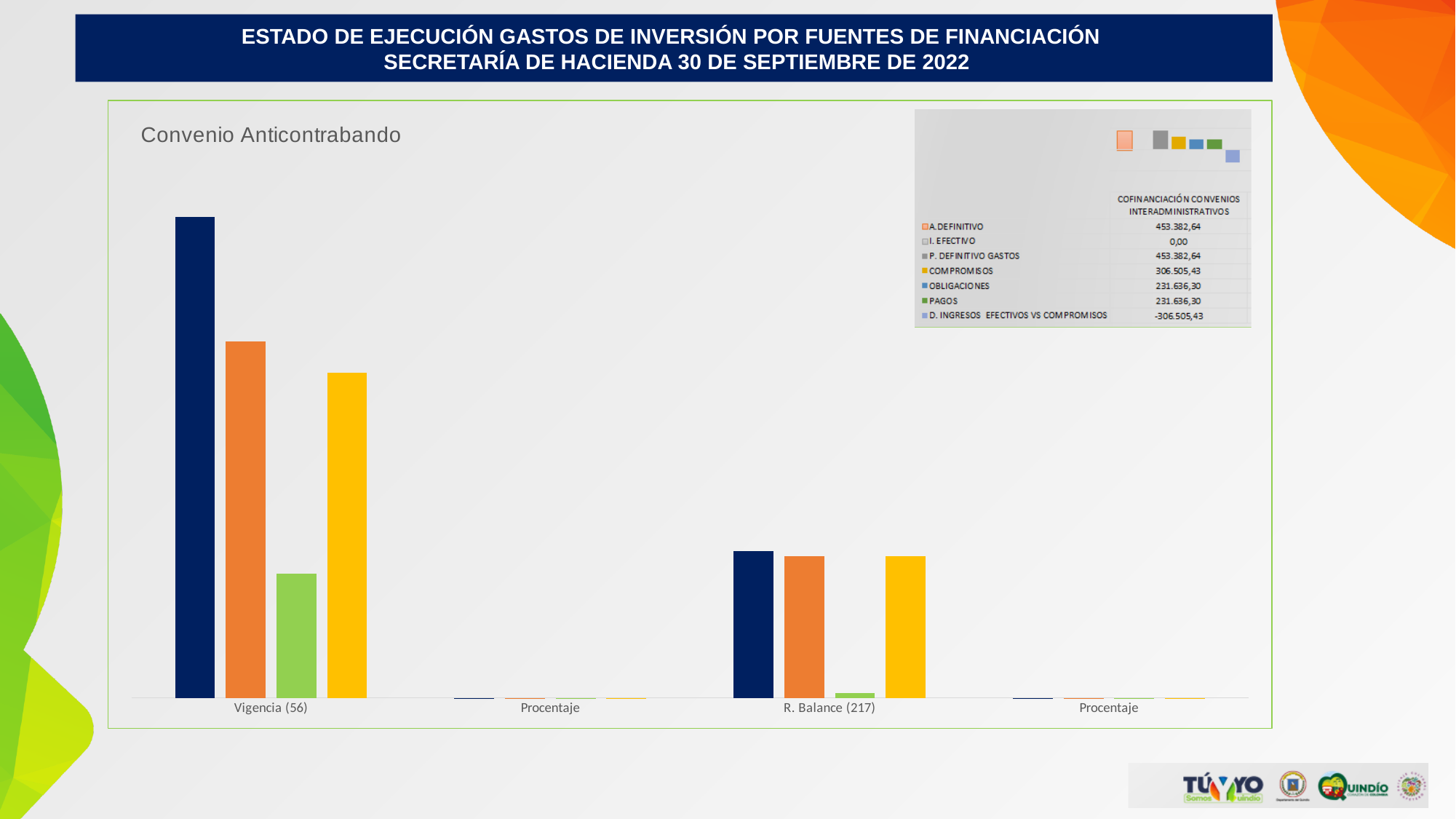
How many bars are plotted in the Vigencia (56) group? 4 Is the tallest bar for Vigencia (56) taller or shorter than the tallest bar for R. Balance (217)? taller What kind of chart is shown on the slide? bar chart Which category on the x axis has the tallest bar in the chart? Vigencia (56) In the Vigencia (56) group, is the yellow bar taller or shorter than the dark blue bar? shorter How many categories are shown on the x axis of the chart? 4 What is the title of the chart? Convenio Anticontrabando In the Vigencia (56) group, is the green bar taller or shorter than the orange bar? shorter What is the label of the third category on the x axis of the chart? R. Balance (217)